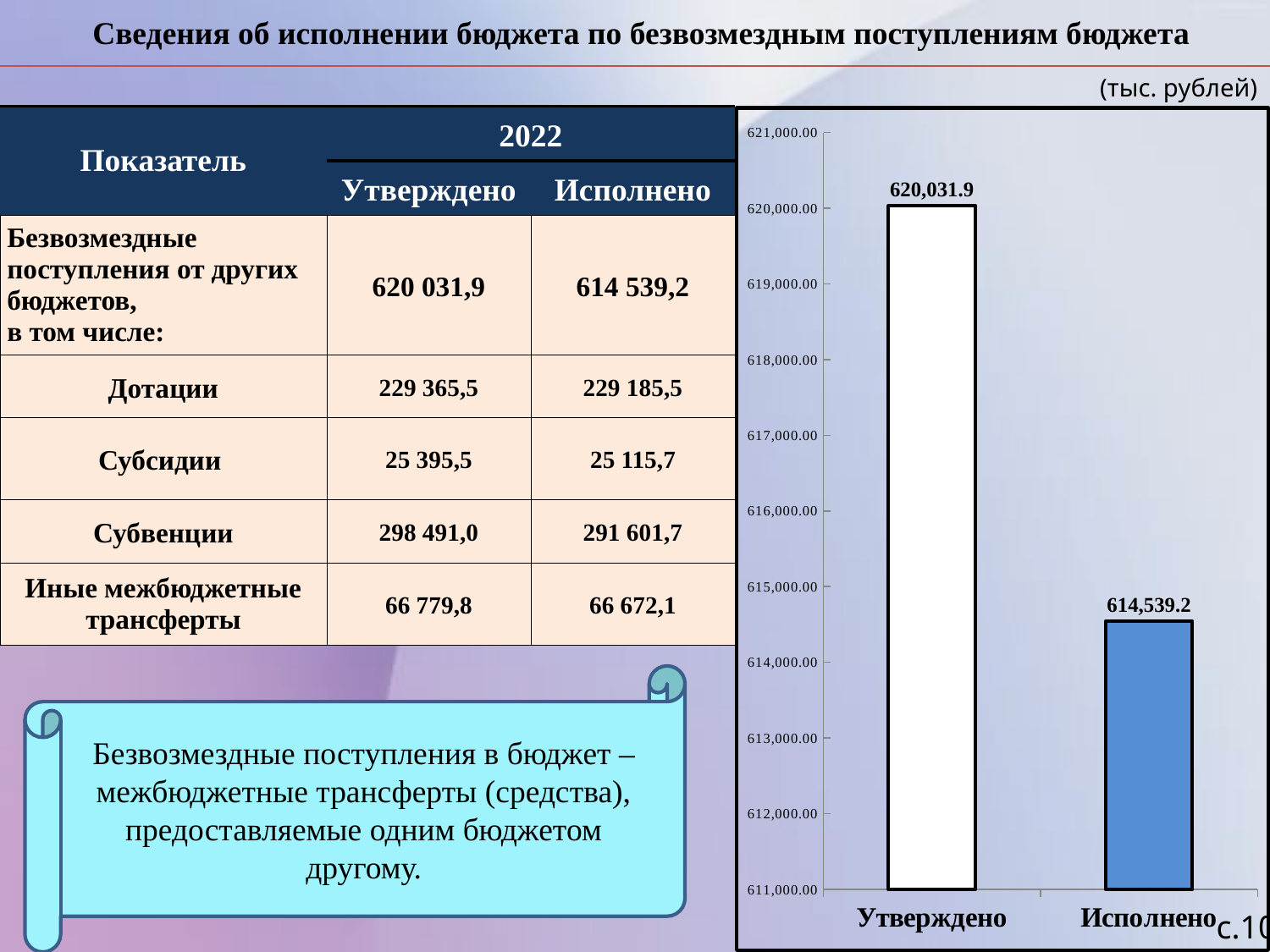
What is the value of the Исполнено bar in the chart? 614,539.2 Which bar in the chart is the highest? Утверждено Which is larger in the chart, Утверждено or Исполнено? Утверждено What is the difference between the Утверждено and Исполнено values in the chart? 5,492.7 Is the value for Утверждено greater or less than 619,000.00? greater What is the value of the Утверждено bar in the chart? 620,031.9 What colour is the Исполнено bar in the chart? blue Do the values in the chart rise or fall from left to right along the x axis? fall Which bar in the chart is the lowest? Исполнено Is the value for Исполнено greater or less than 615,000.00? less What kind of chart is shown on the slide? bar chart How many bars are plotted in the chart? 2